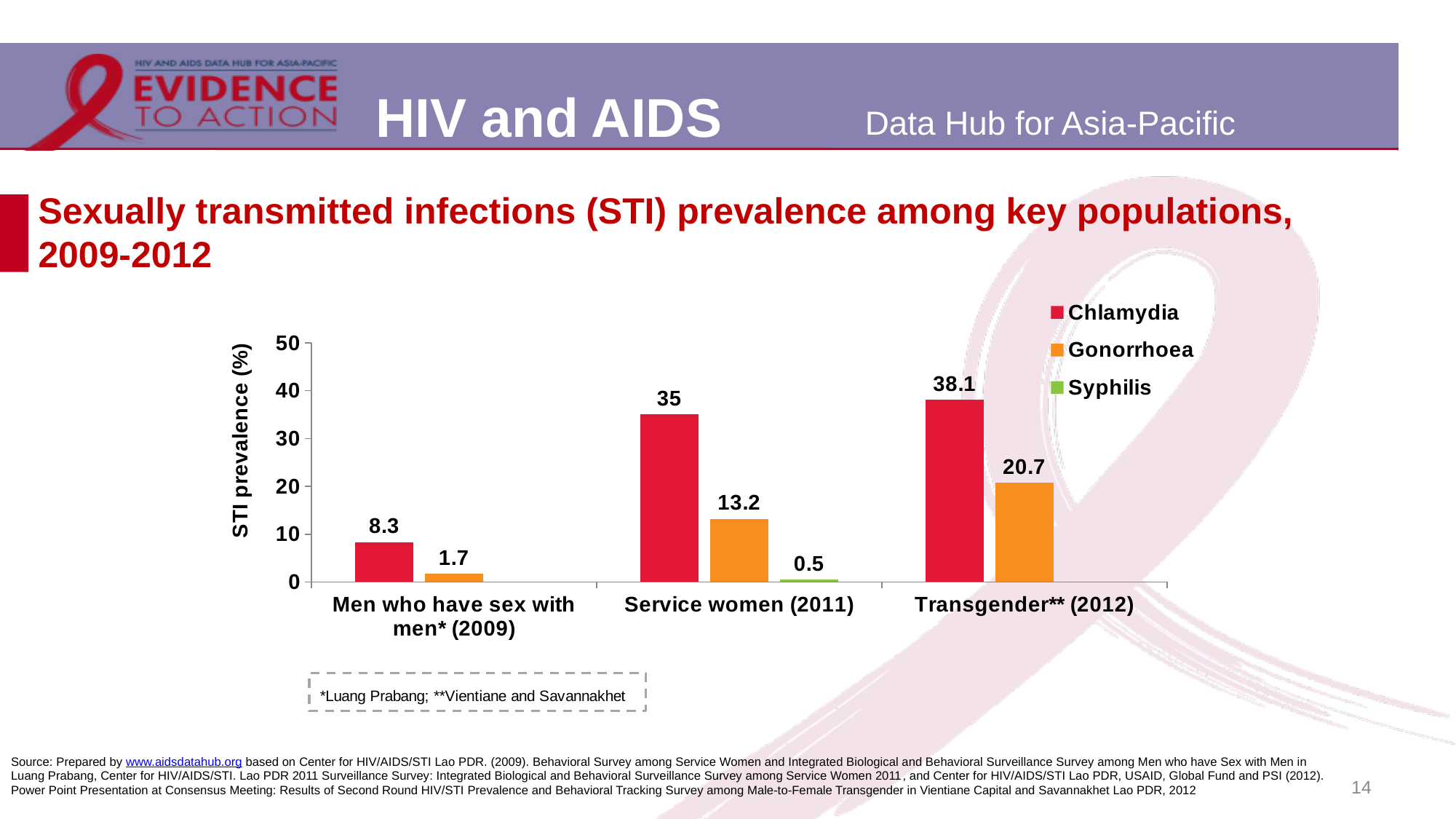
Which population has the highest Chlamydia prevalence? Transgender** (2012) What is the Chlamydia prevalence among Service women (2011)? 35 How many series does the legend list? 3 Which population has the lowest Gonorrhoea prevalence? Men who have sex with men* (2009) What is the label of the y axis? STI prevalence (%) What is the difference between the Chlamydia and Gonorrhoea prevalence among Transgender** (2012)? 17.4 What is the Syphilis prevalence among Service women (2011)? 0.5 What is the Gonorrhoea prevalence among Men who have sex with men* (2009)? 1.7 What is the Gonorrhoea prevalence among Transgender** (2012)? 20.7 What kind of chart is shown on the slide? Bar chart Which is larger: Chlamydia prevalence among Men who have sex with men* (2009) or Gonorrhoea prevalence among Service women (2011)? Gonorrhoea prevalence among Service women (2011) How many population groups are shown on the x axis? 3